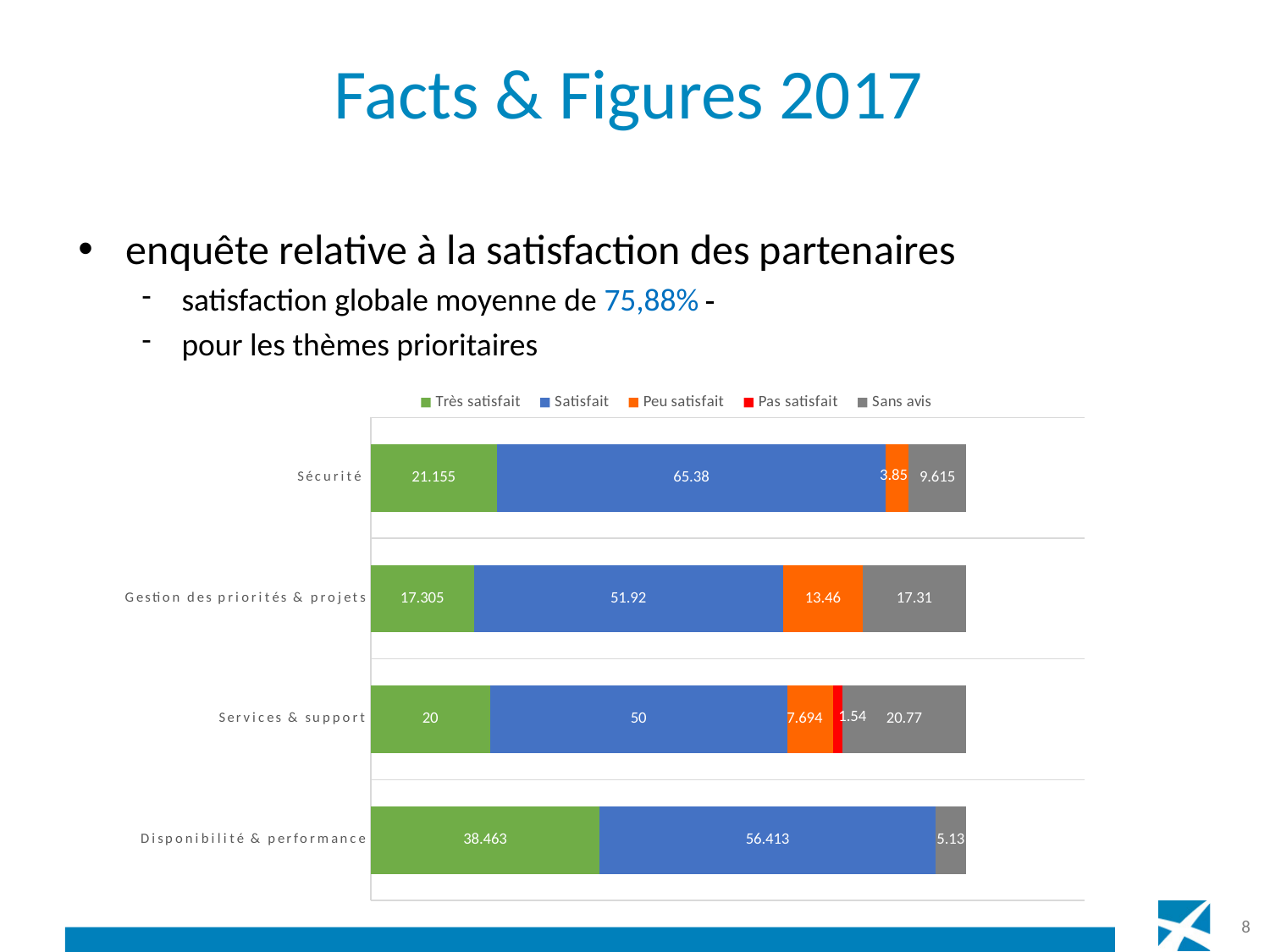
What is the Très satisfait value for Disponibilité & performance? 38.463 What is the Pas satisfait value for Services & support? 1.54 What is the Satisfait value for Sécurité? 65.38 Which category has the highest Très satisfait value? Disponibilité & performance How many series does the legend list? 5 What kind of chart is shown on the slide? Stacked bar chart Which category has the lowest Satisfait value? Services & support What is the Peu satisfait value for Gestion des priorités & projets? 13.46 Which is larger: the Sans avis value for Services & support or for Gestion des priorités & projets? Services & support What is the Sans avis value for Disponibilité & performance? 5.13 How many categories are shown on the chart? 4 What is the difference between the Satisfait values for Sécurité and Gestion des priorités & projets? 13.46